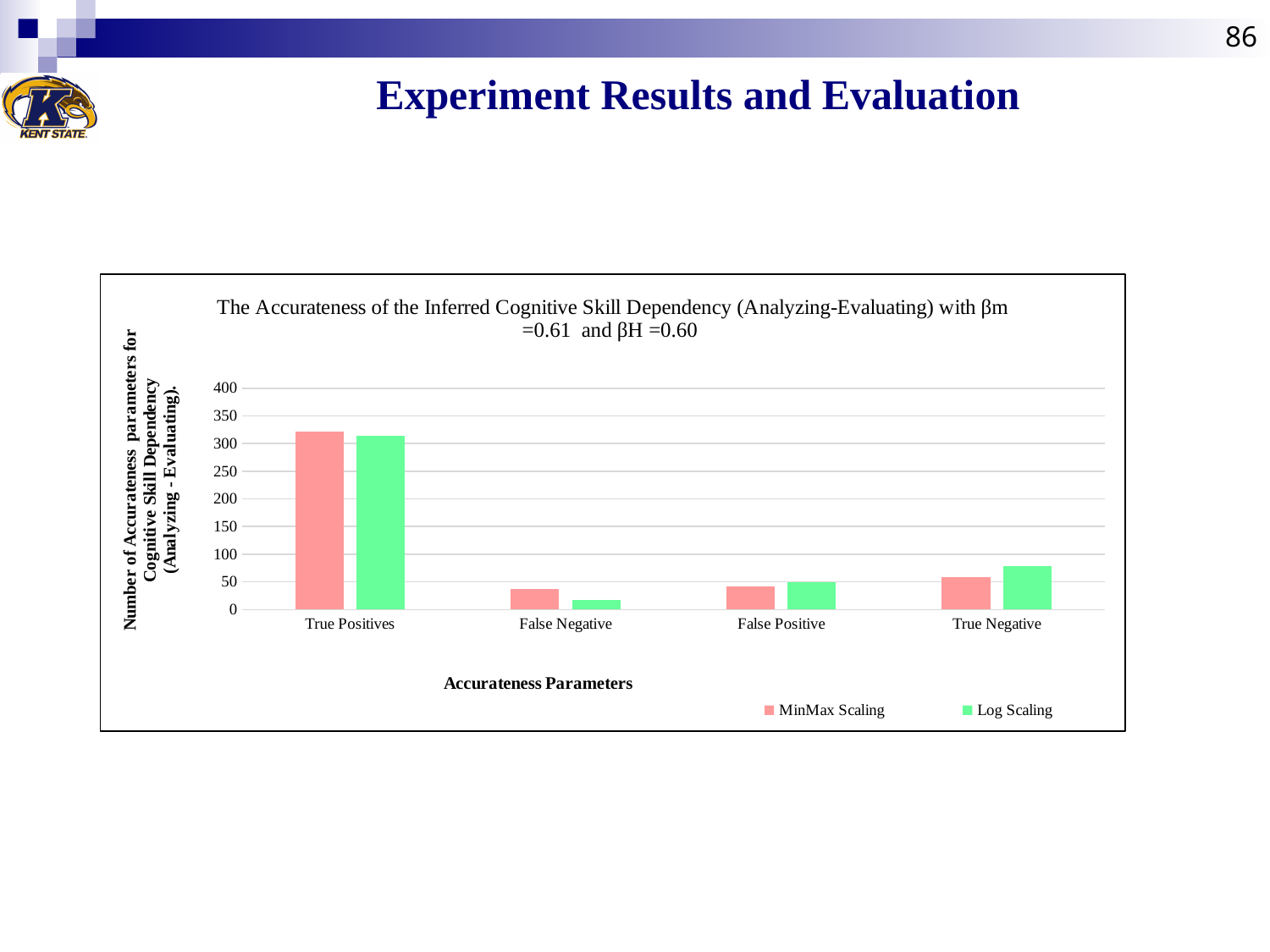
For False Negative, which series has the larger value, MinMax Scaling or Log Scaling? MinMax Scaling Which category has the lowest value for Log Scaling? False Negative For True Negative, which series has the larger value, MinMax Scaling or Log Scaling? Log Scaling How many categories are shown on the x axis of the chart? 4 Which category has the highest value for Log Scaling? True Positives Which category has the highest value for MinMax Scaling? True Positives How many series does the chart's legend list? 2 Is the Log Scaling value for False Negative greater or less than 50? less Is the Log Scaling value for True Negative greater or less than 50? greater Is the MinMax Scaling value for True Positives greater or less than 300? greater What kind of chart is shown on the slide? bar chart What is the x-axis title of the chart? Accurateness Parameters